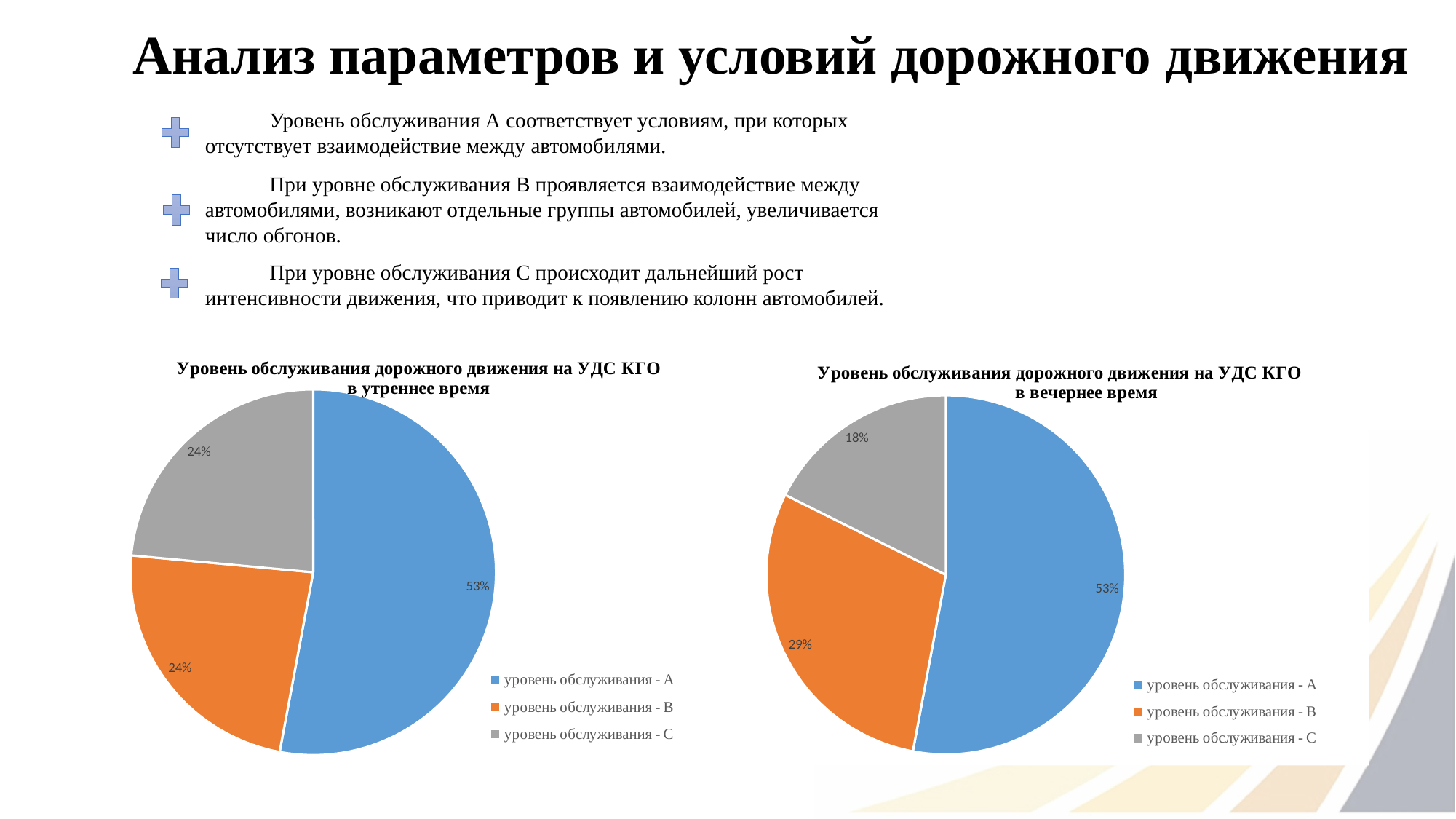
In the right chart (в вечернее время), which level of service has the smallest slice? уровень обслуживания - C In the right chart (в вечернее время), what share does уровень обслуживания - B have? 29% In the left chart (в утреннее время), what share does уровень обслуживания - B have? 24% What type of chart is used on this slide? Pie chart In the right chart (в вечернее время), what share does уровень обслуживания - C have? 18% In the right chart (в вечернее время), what is the difference between the shares of уровень обслуживания - B and уровень обслуживания - C? 11% Which is larger in the right chart (в вечернее время): the share of уровень обслуживания - B or уровень обслуживания - C? уровень обслуживания - B How many slices does the left chart (в утреннее время) have? 3 In the right chart (в вечернее время), which level of service has the largest slice? уровень обслуживания - A In the left chart (в утреннее время), which level of service has the largest slice? уровень обслуживания - A What is the title of the right chart? Уровень обслуживания дорожного движения на УДС КГО в вечернее время